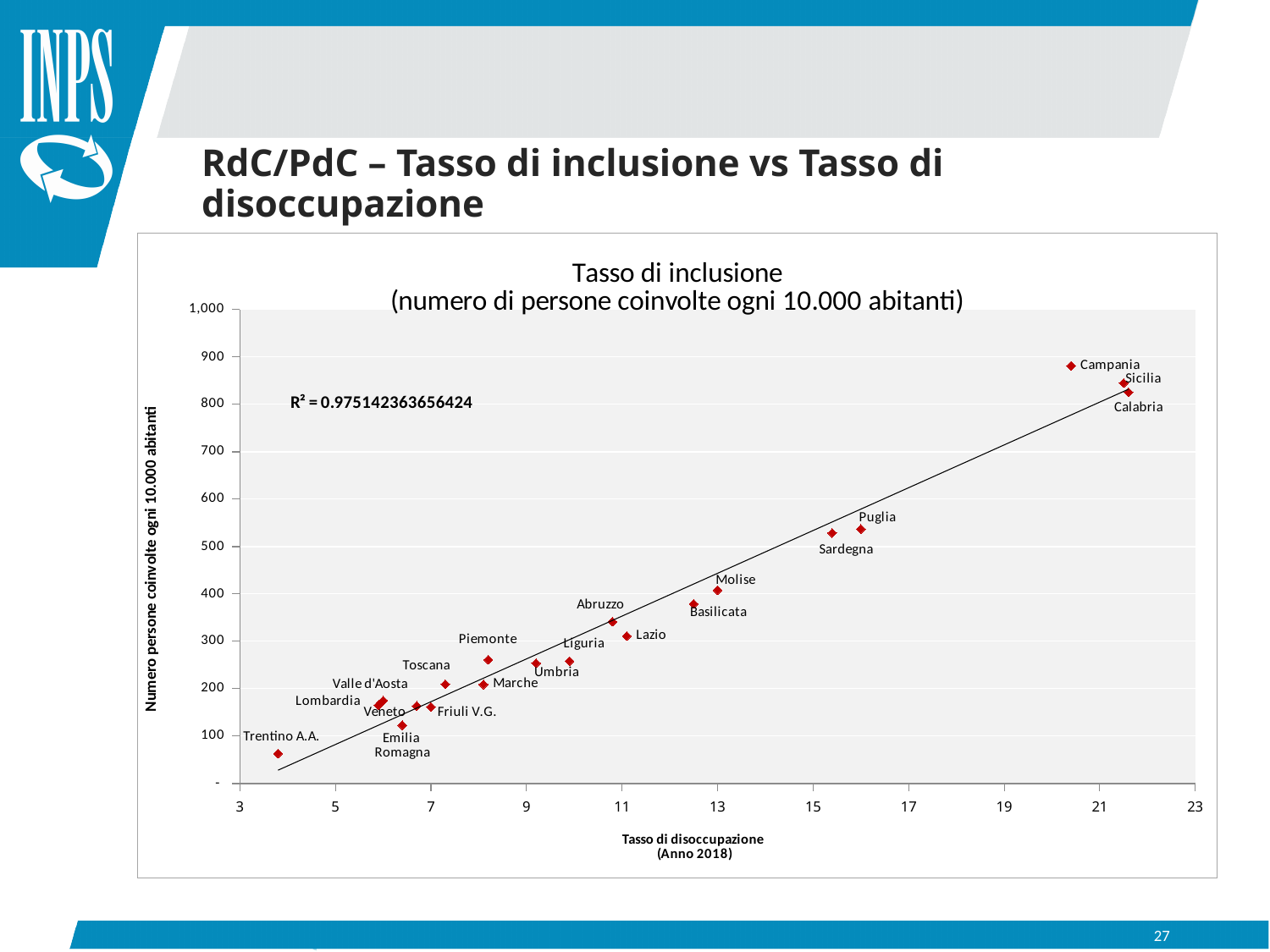
Which has a higher inclusion rate, Abruzzo or Toscana? Abruzzo Is the inclusion rate for Campania greater or less than 800? greater Is the inclusion rate for Piemonte greater or less than 300? less Is the inclusion rate for Trentino A.A. greater or less than 100? less What is the R² value printed on the chart? R² = 0.975142363656424 What is the title of the x axis of the chart? Tasso di disoccupazione (Anno 2018) Which region has the lowest inclusion rate on the chart? Trentino A.A. Which region has the highest inclusion rate (numero persone coinvolte ogni 10.000 abitanti)? Campania Which region has the lowest unemployment rate (tasso di disoccupazione) on the chart? Trentino A.A. What kind of chart is shown on the slide? Scatter chart